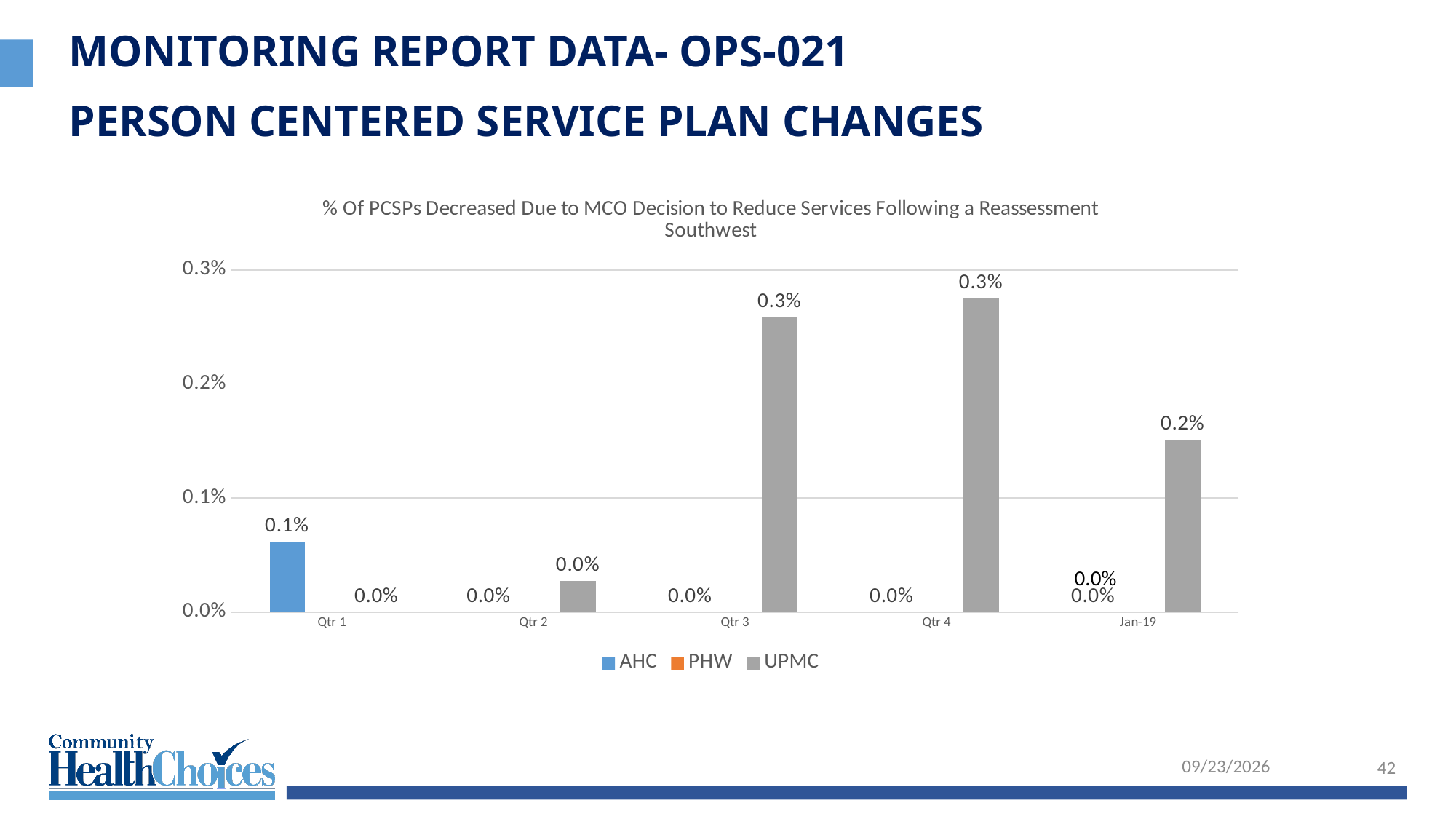
What is the value for UPMC in Jan-19? 0.2% What is the difference between the UPMC value in Qtr 3 and the UPMC value in Jan-19? 0.1% Is the value for UPMC in Jan-19 greater or less than 0.1%? greater Do the UPMC values rise or fall from Qtr 2 to Qtr 4? rise What is the value for UPMC in Qtr 3? 0.3% What colour represents AHC in the legend? blue What is the value for AHC in Qtr 1? 0.1% How many series does the legend list? 3 What kind of chart is shown on the slide? bar chart Which is larger, the UPMC value in Qtr 3 or the UPMC value in Jan-19? Qtr 3 How many categories are shown along the x axis? 5 Which series has the highest value in Qtr 3? UPMC